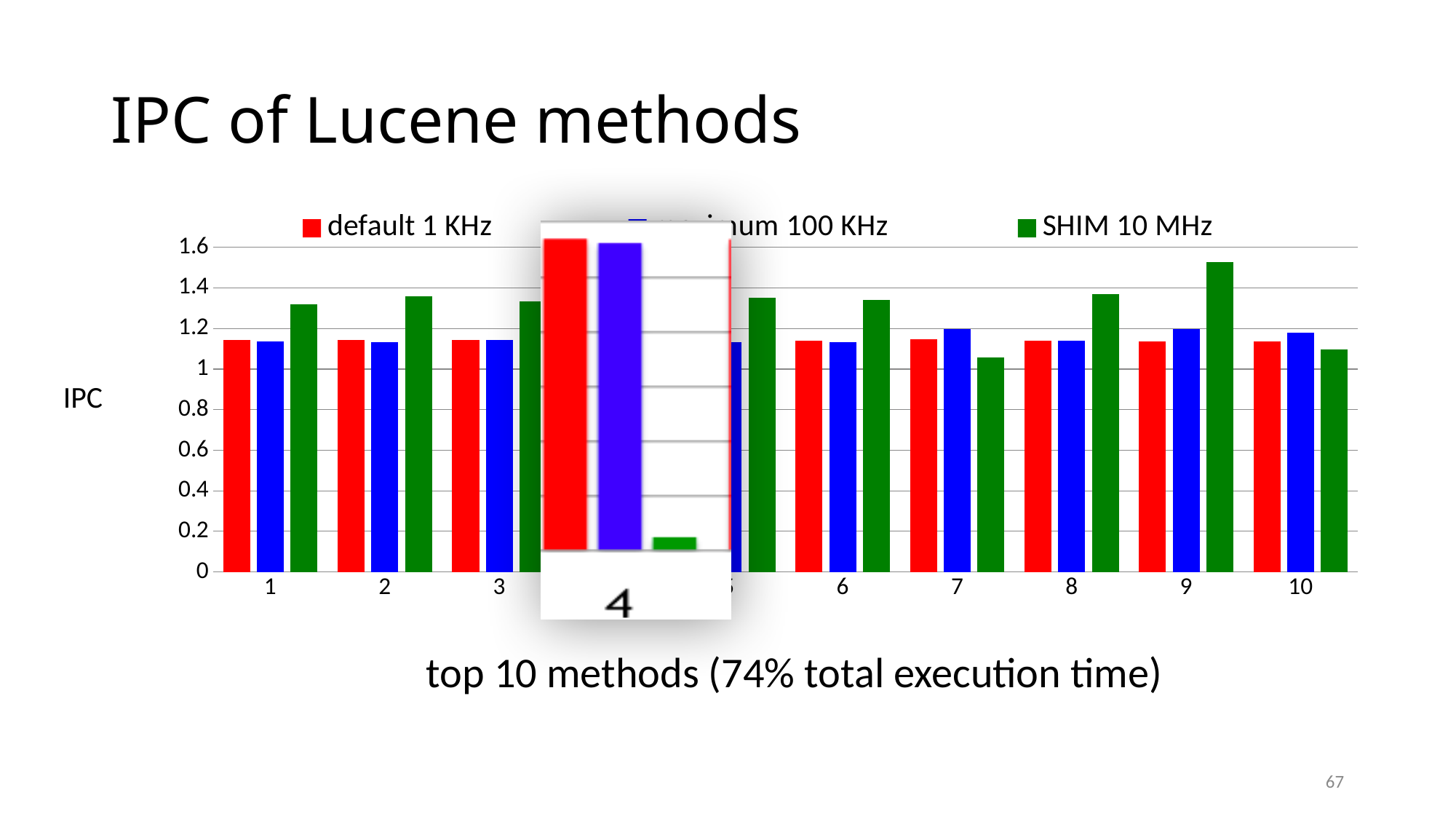
Which is larger: the SHIM 10 MHz value for method 9 or for method 7? method 9 How many series does the chart's legend list? 3 What kind of chart is shown on the slide? bar chart What is the title of the chart? IPC of Lucene methods Is the SHIM 10 MHz value for method 9 greater or less than 1.4? greater Is the SHIM 10 MHz value for method 7 greater or less than 1.2? less Which method has the highest SHIM 10 MHz value? 9 How many methods (categories) are plotted along the x axis? 10 What label is shown on the y axis? IPC Is the SHIM 10 MHz value for method 2 greater or less than 1.2? greater For method 1, which is larger: the SHIM 10 MHz value or the default 1 KHz value? SHIM 10 MHz